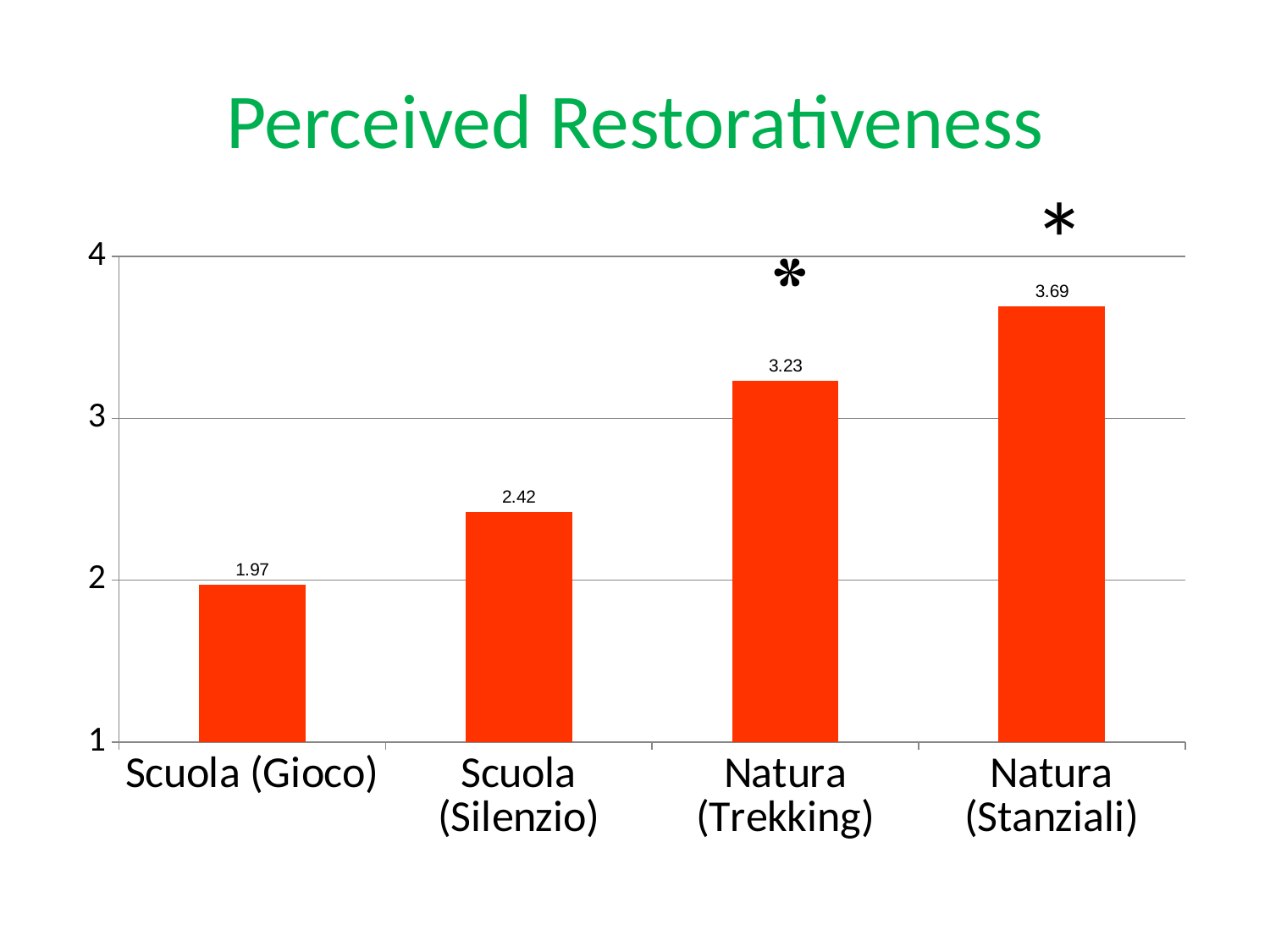
Do the values rise or fall from left to right along the x axis? rise What is the difference between the values for Natura (Trekking) and Scuola (Silenzio)? 0.81 Which category has the lowest value? Scuola (Gioco) What is the value for Scuola (Gioco)? 1.97 Which category has the highest value? Natura (Stanziali) What is the value for Natura (Stanziali)? 3.69 What kind of chart is shown on the slide? bar chart How many categories are shown on the x axis? 4 Which is larger, the value for Scuola (Silenzio) or the value for Natura (Trekking)? Natura (Trekking) What is the value for Natura (Trekking)? 3.23 Is the value for Scuola (Silenzio) greater or less than 3? less What is the difference between the values for Natura (Stanziali) and Scuola (Gioco)? 1.72